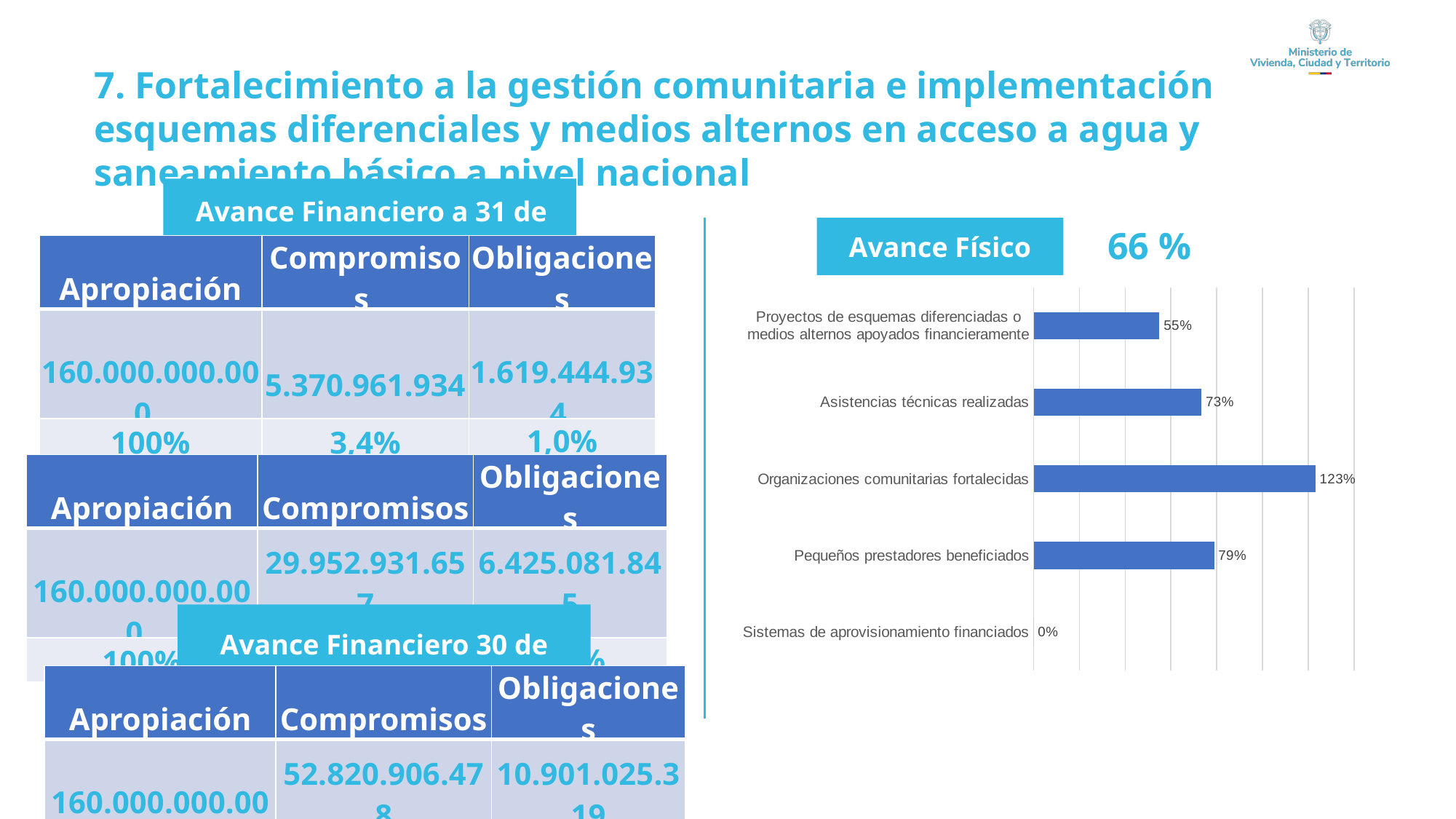
What is the value for Organizaciones comunitarias fortalecidas? 123% What overall percentage is shown next to the 'Avance Físico' label above the bar chart? 66 % What is the value for Sistemas de aprovisionamiento financiados? 0% What kind of chart is shown on the right side of the slide? bar chart What is the difference between the values for Organizaciones comunitarias fortalecidas and Pequeños prestadores beneficiados? 44% What is the value for Pequeños prestadores beneficiados? 79% What is the value for Proyectos de esquemas diferenciadas o medios alternos apoyados financieramente? 55% What is the value for Asistencias técnicas realizadas? 73% Which category has the lowest value in the bar chart? Sistemas de aprovisionamiento financiados How many categories does the bar chart show? 5 Which category has the highest value in the bar chart? Organizaciones comunitarias fortalecidas Which is larger: the value for Asistencias técnicas realizadas or the value for Pequeños prestadores beneficiados? Pequeños prestadores beneficiados